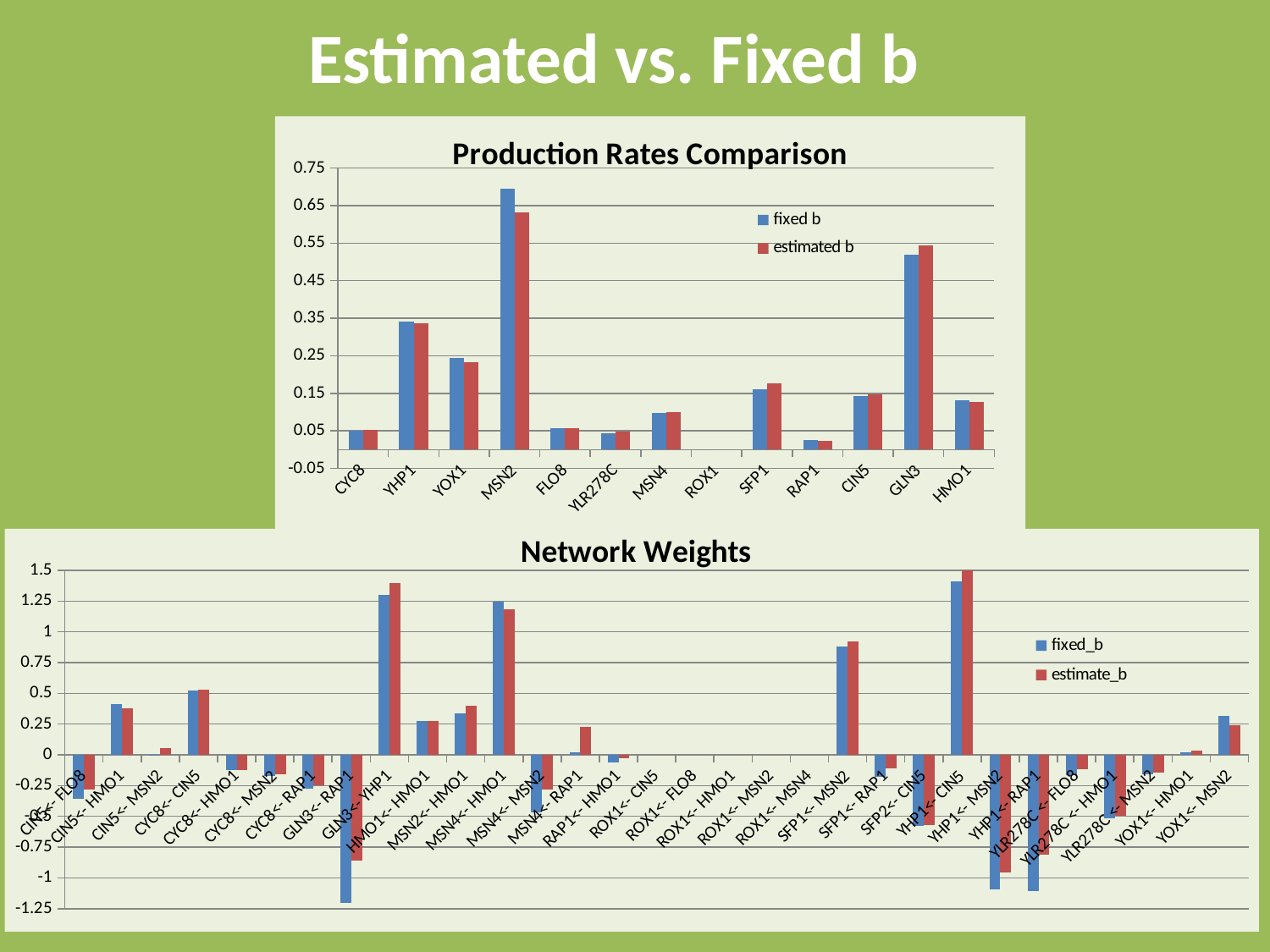
In the Production Rates Comparison chart, is the fixed b value for CYC8 greater or less than 0.15? less What kind of chart is the Network Weights chart? bar chart In the Production Rates Comparison chart, is the fixed b value for MSN2 greater or less than 0.55? greater In the Production Rates Comparison chart, how many series does the legend list? 2 In the Network Weights chart, is the fixed_b value for SFP1<- MSN2 greater or less than 0.75? greater In the Production Rates Comparison chart, how many categories are shown on the x axis? 13 In the Network Weights chart, how many series does the legend list? 2 In the Production Rates Comparison chart, which is larger, the fixed b value for YHP1 or the fixed b value for YOX1? YHP1 In the Network Weights chart, which category has the lowest (most negative) value? GLN3<- RAP1 In the Production Rates Comparison chart, which category has the highest value? MSN2